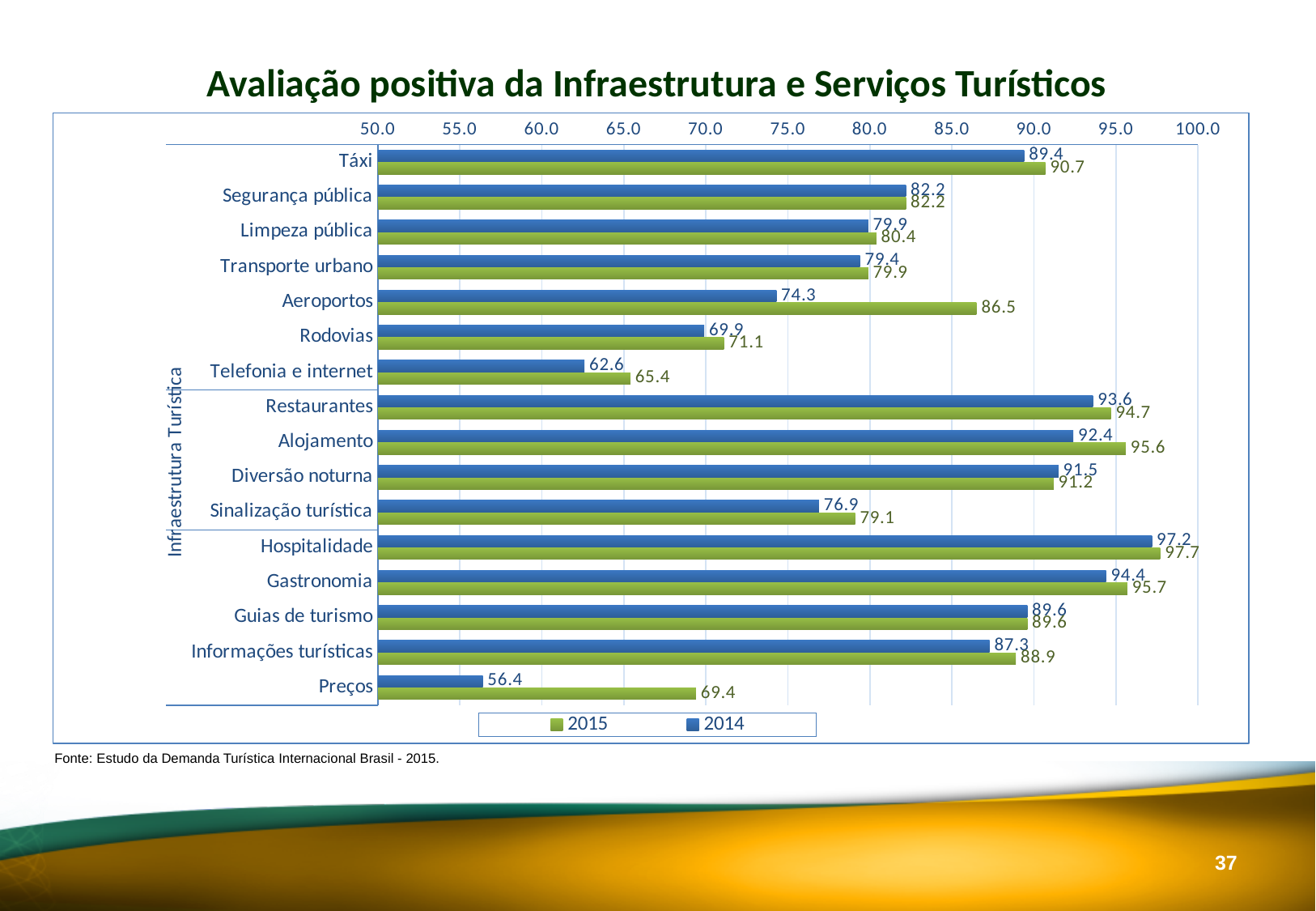
How many series does the legend list? 2 Which category has the highest 2015 value? Hospitalidade Which is larger for Alojamento, the 2014 value or the 2015 value? 2015 Which category has the lowest 2015 value? Telefonia e internet What is the difference between the 2015 and 2014 values for Aeroportos? 12.2 What is the 2014 value for Preços? 56.4 What is the 2015 value for Aeroportos? 86.5 Which category has the lowest 2014 value? Preços How many categories are shown on the chart? 16 What kind of chart is shown on the slide? Bar chart What is the 2015 value for Telefonia e internet? 65.4 What is the difference between the 2015 and 2014 values for Preços? 13.0